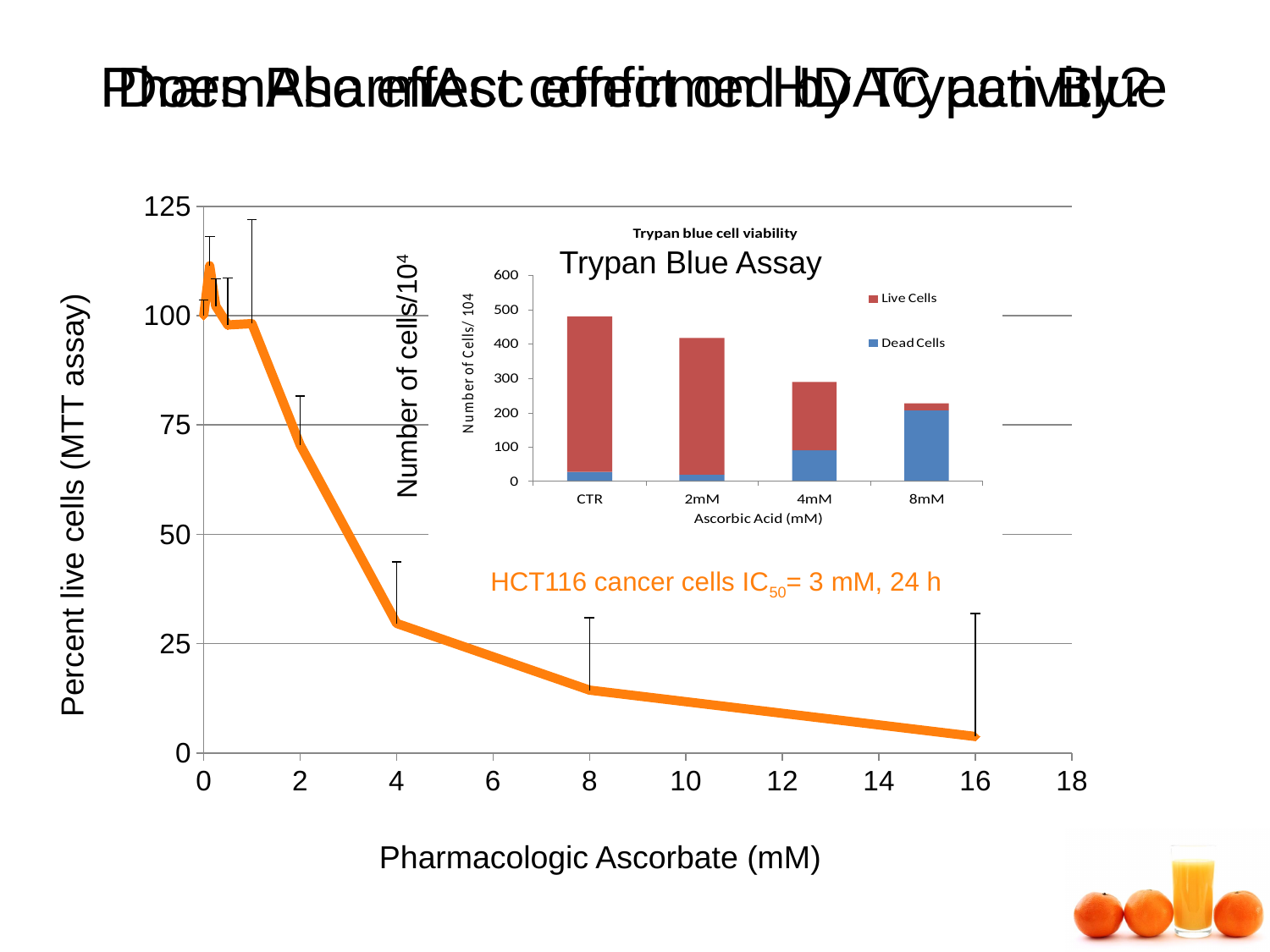
In the 'Trypan blue cell viability' chart, is the total bar height for 8mM greater or less than 300? less In the 'Trypan blue cell viability' chart, which category has the shortest stacked bar? 8mM In the 'Trypan blue cell viability' chart, is the total bar height for CTR greater or less than 400? greater In the 'Trypan blue cell viability' chart, how many series does the legend list? 2 What type of chart is the inset chart titled 'Trypan blue cell viability'? bar chart In the 'Trypan blue cell viability' chart, which category has the tallest stacked bar? CTR In the 'Trypan blue cell viability' chart, how many categories are shown on the x axis? 4 In the 'Trypan blue cell viability' chart, which category has the largest Dead Cells segment? 8mM In the large line chart, what is the y-axis title? Percent live cells (MTT assay) In the 'Trypan blue cell viability' chart, what is the x-axis title? Ascorbic Acid (mM) In the large line chart, is the percent live cells at 8 mM greater or less than 25? less In the large line chart, do the percent live cells rise or fall as Pharmacologic Ascorbate increases from 2 to 16 mM? fall